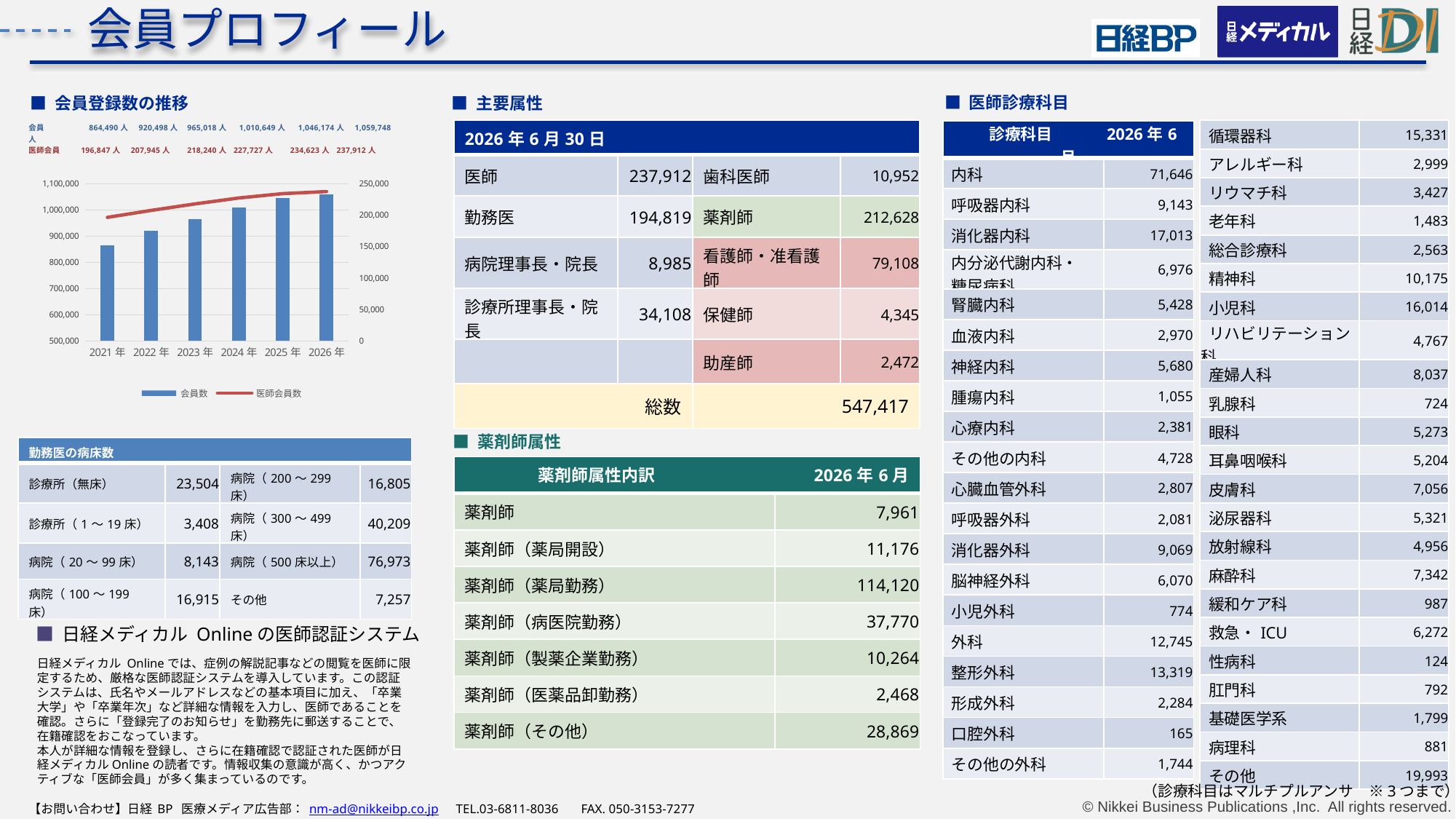
In the 会員登録数の推移 chart, what is the difference in 医師会員 between 2026年 and 2021年? 41,065 In the 会員登録数の推移 chart, what is the 会員数 value for 2026年? 1,059,748 How many years are shown on the x axis of the 会員登録数の推移 chart? 6 In the 会員登録数の推移 chart, by how much did 会員数 increase from 2021年 to 2026年? 195,258 In the 会員登録数の推移 chart, which year has the highest 会員数? 2026年 How many series does the legend of the 会員登録数の推移 chart list? 2 In the 会員登録数の推移 chart, is the 会員数 for 2024年 larger than that for 2023年? Yes In the 会員登録数の推移 chart, what is the 会員数 value for 2021年? 864,490 人 In the 会員登録数の推移 chart, what is the 医師会員 value for 2026年? 237,912 人 In the 会員登録数の推移 chart, which year has the lowest 医師会員 value? 2021年 In the 会員登録数の推移 chart, what is the 医師会員 value for 2023年? 218,240 人 In the 会員登録数の推移 chart, is the 会員数 bar for 2023年 greater or less than 1,000,000? less